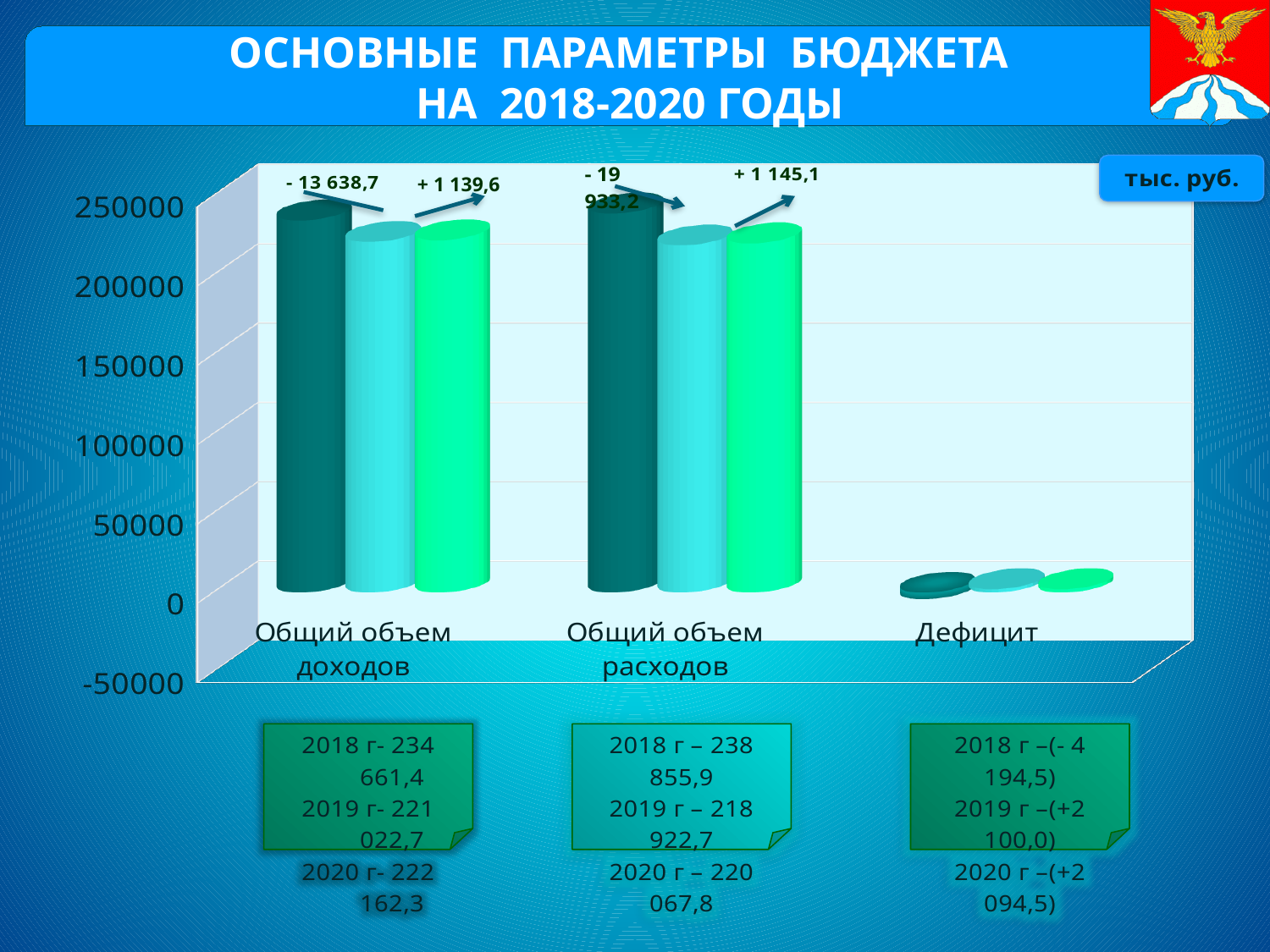
Which is larger in 2018: Общий объем доходов or Общий объем расходов? Общий объем расходов Is the value for Общий объем доходов in 2018 greater or less than 200000? greater In which year is Общий объем доходов the highest? 2018 What is the difference between Общий объем доходов in 2018 and in 2019? 13 638,7 What is the value of Общий объем расходов for 2020? 220 067,8 What is the value of Общий объем расходов for 2019? 218 922,7 What is the value of Общий объем доходов for 2018? 234 661,4 What kind of chart is shown on the slide? bar chart How many categories are shown along the x axis of the chart? 3 What is the value of Дефицит for 2020? +2 094,5 Is the value for Дефицит in 2019 greater or less than 50000? less In what units are the chart values expressed, according to the label on the slide? тыс. руб.